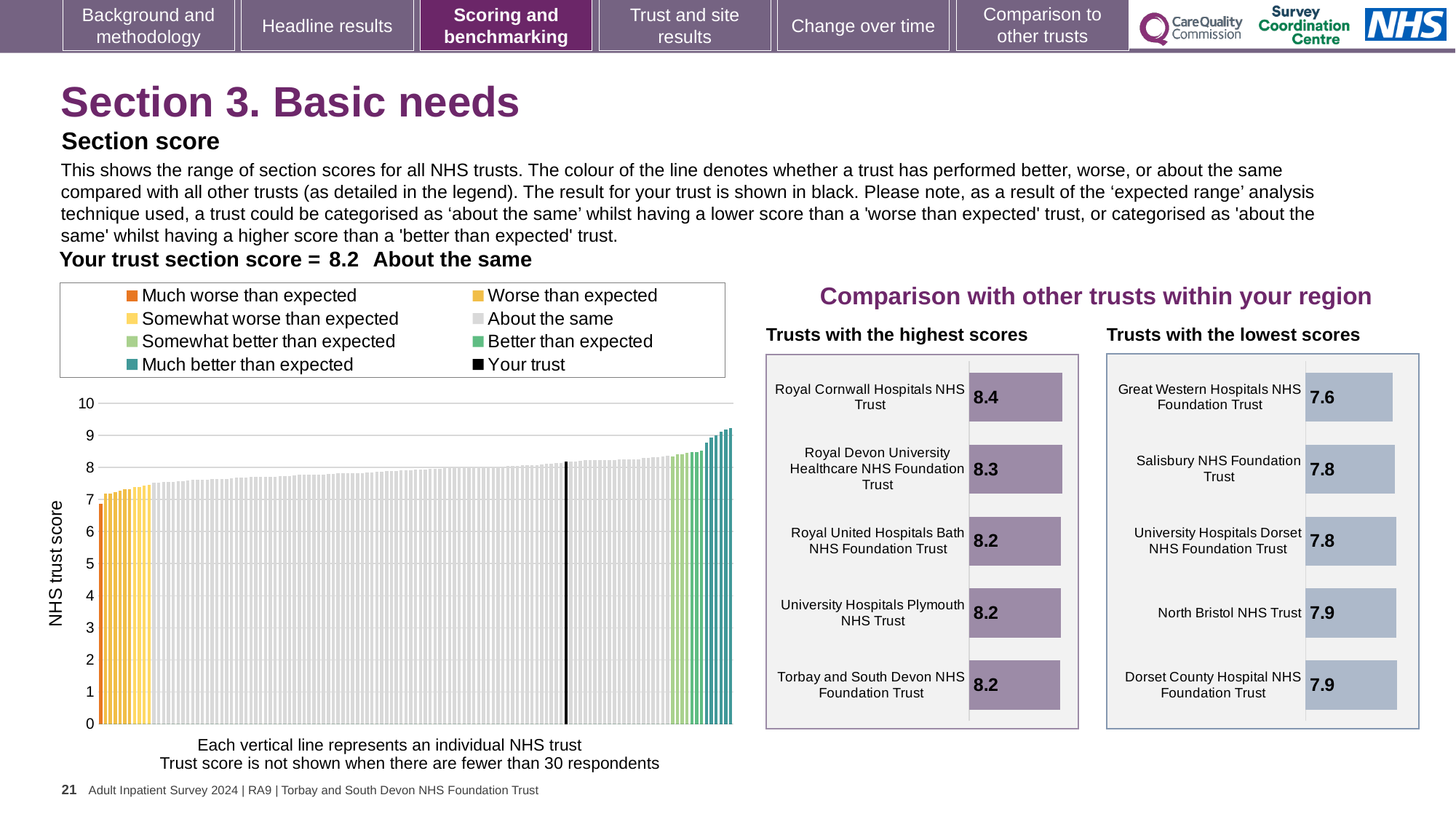
In the 'Trusts with the highest scores' chart, how many trusts are shown? 5 What kind of chart is the large chart on the left showing NHS trust scores? Bar chart How many entries does the legend above the large chart on the left list? 8 In the 'Trusts with the lowest scores' chart, what is the score for Great Western Hospitals NHS Foundation Trust? 7.6 In the 'Trusts with the highest scores' chart, what is the difference between the scores of Royal Cornwall Hospitals NHS Trust and Torbay and South Devon NHS Foundation Trust? 0.2 In the 'Trusts with the highest scores' chart, what is the score for Royal Cornwall Hospitals NHS Trust? 8.4 In the large chart on the left, what is the label on the vertical axis? NHS trust score In the 'Trusts with the highest scores' chart, which trust has the highest score? Royal Cornwall Hospitals NHS Trust In the 'Trusts with the lowest scores' chart, what is the difference between the scores of Dorset County Hospital NHS Foundation Trust and Great Western Hospitals NHS Foundation Trust? 0.3 In the large chart on the left, is the value of the highest bar greater or less than 9? greater In the 'Trusts with the lowest scores' chart, which trust has the lowest score? Great Western Hospitals NHS Foundation Trust In the 'Trusts with the lowest scores' chart, which has the larger score: Salisbury NHS Foundation Trust or North Bristol NHS Trust? North Bristol NHS Trust